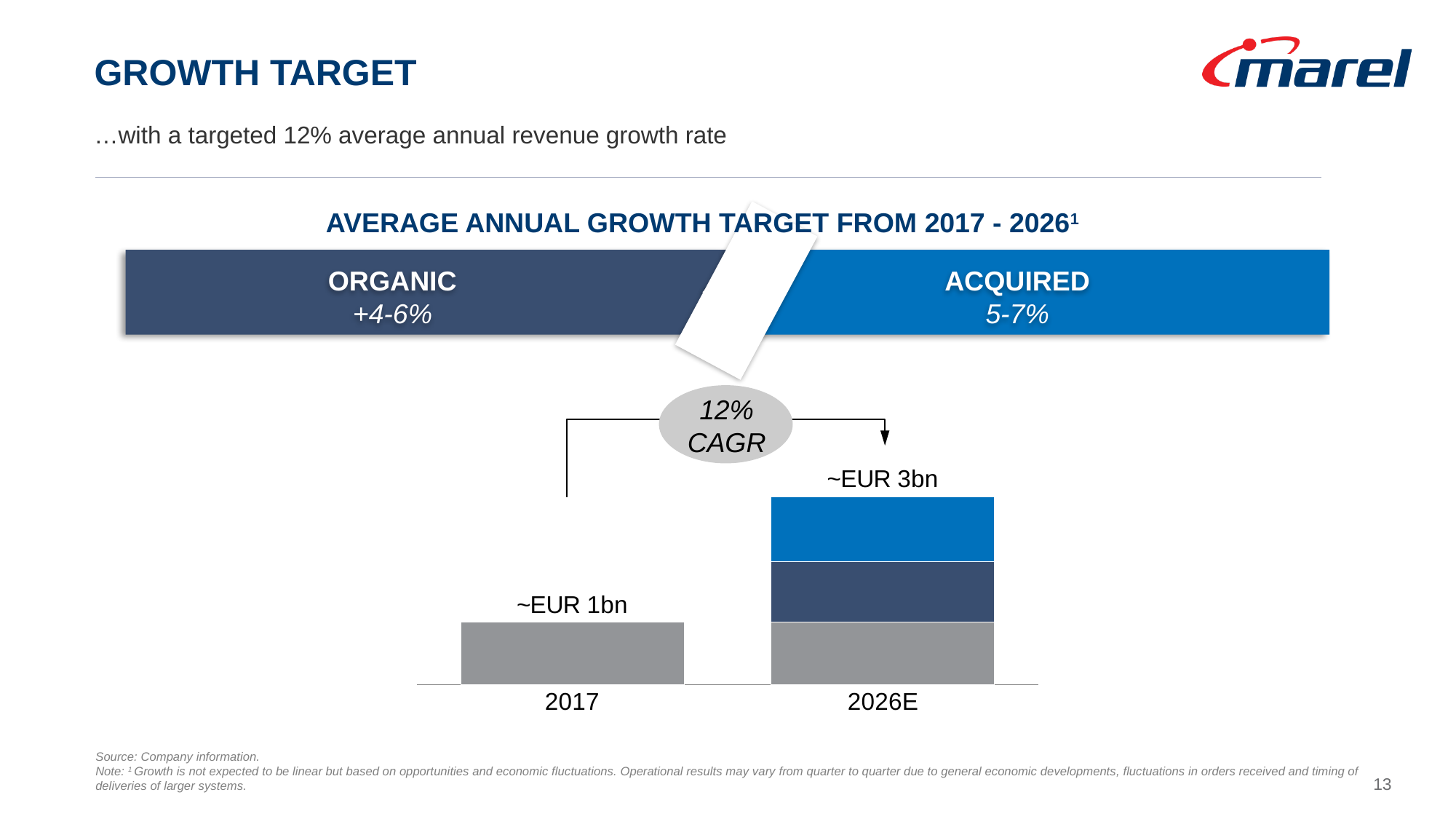
What growth rate is shown in the oval between the two bars? 12% CAGR How many categories are shown on the x axis of the chart? 2 Do the values rise or fall from 2017 to 2026E? Rise What kind of chart is shown on the slide? Stacked bar chart How many stacked segments make up the 2026E bar? 3 Which category has the taller bar, 2017 or 2026E? 2026E What is the value label shown on the 2017 bar? ~EUR 1bn Which category has the highest value in the chart? 2026E Which category has the lowest value in the chart? 2017 What is the value label shown on the 2026E bar? ~EUR 3bn